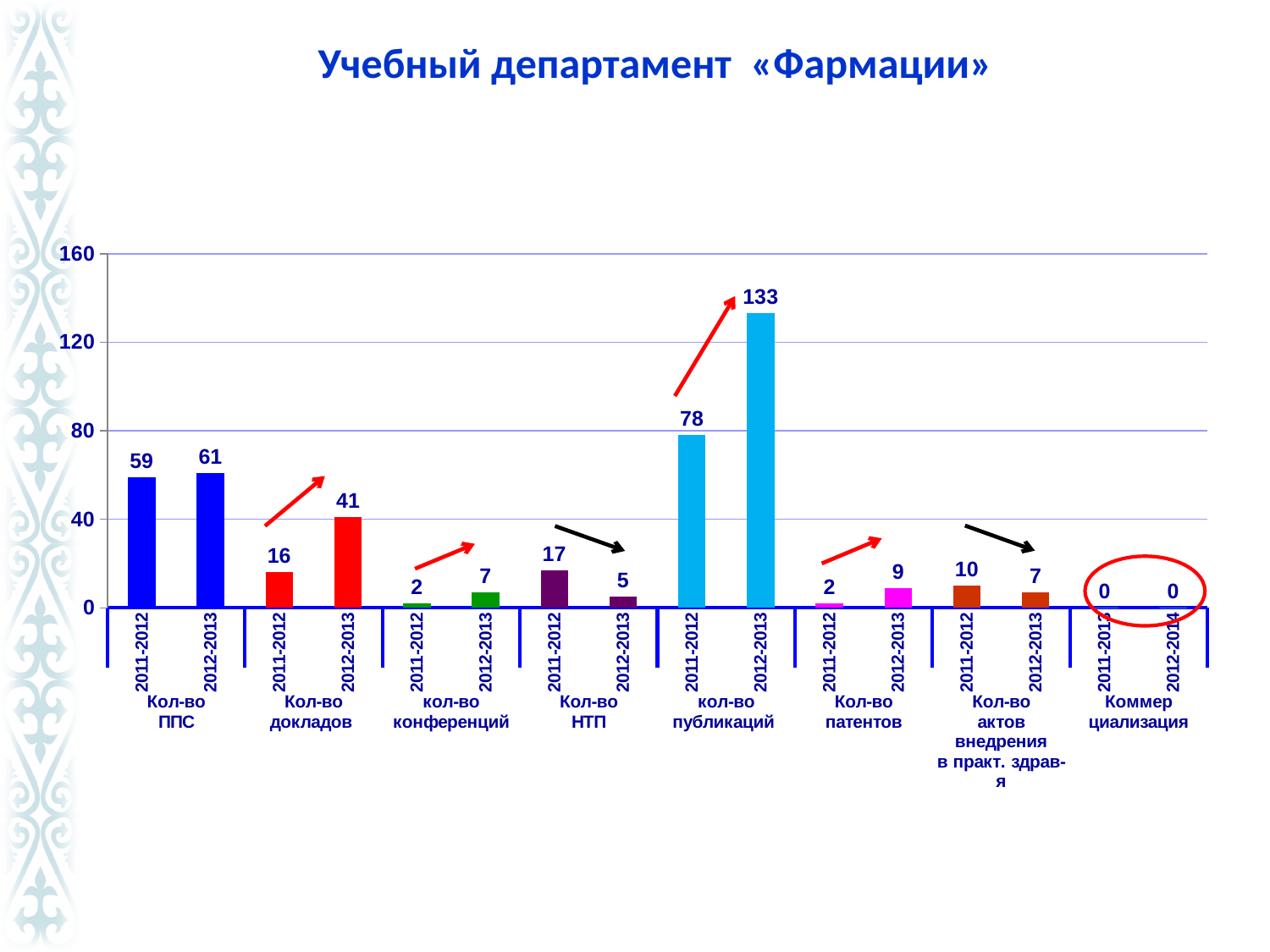
Is the value for Кол-во ППС in 2012-2013 greater or less than 40? greater Which bar has the highest value on the chart? кол-во публикаций, 2012-2013 Which is larger for Кол-во НТП: the 2011-2012 value or the 2012-2013 value? 2011-2012 What is the value for Кол-во докладов in 2011-2012? 16 What kind of chart is shown on the slide? bar chart What is the value for Кол-во НТП in 2012-2013? 5 What is the value for кол-во публикаций in 2012-2013? 133 How many category groups are shown on the x axis of the chart? 8 What is the value for Кол-во патентов in 2012-2013? 9 Which is larger for Кол-во актов внедрения в практ. здрав-я: the 2011-2012 value or the 2012-2013 value? 2011-2012 What is the difference between the 2012-2013 and 2011-2012 values for кол-во публикаций? 55 What is the difference between the 2012-2013 and 2011-2012 values for Кол-во докладов? 25